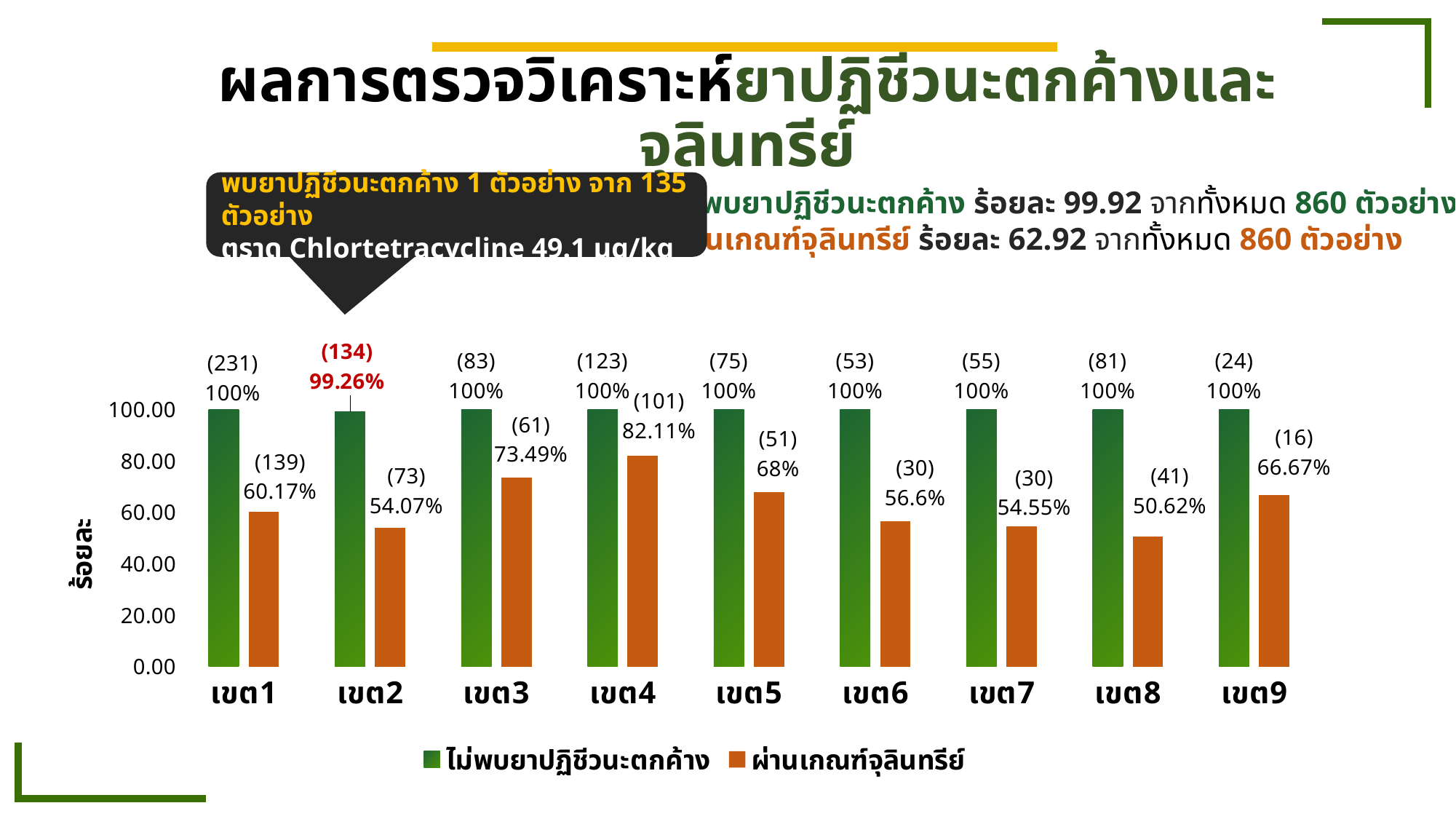
How many categories (เขต) are shown on the x axis? 9 How many series does the legend list? 2 What is the difference between the ไม่พบยาปฏิชีวนะตกค้าง and ผ่านเกณฑ์จุลินทรีย์ values in เขต1? 39.83% Which category has the lowest value for ไม่พบยาปฏิชีวนะตกค้าง? เขต2 Which is larger: the ผ่านเกณฑ์จุลินทรีย์ value in เขต3 or in เขต6? เขต3 Which category has the highest value for ผ่านเกณฑ์จุลินทรีย์? เขต4 What is the value for ผ่านเกณฑ์จุลินทรีย์ in เขต9? 66.67% What is the value for ผ่านเกณฑ์จุลินทรีย์ in เขต4? 82.11% Is the value for ผ่านเกณฑ์จุลินทรีย์ in เขต8 greater or less than 60.00? less Which category has the lowest value for ผ่านเกณฑ์จุลินทรีย์? เขต8 What kind of chart is shown on the slide? bar chart What is the value for ไม่พบยาปฏิชีวนะตกค้าง in เขต2? 99.26%